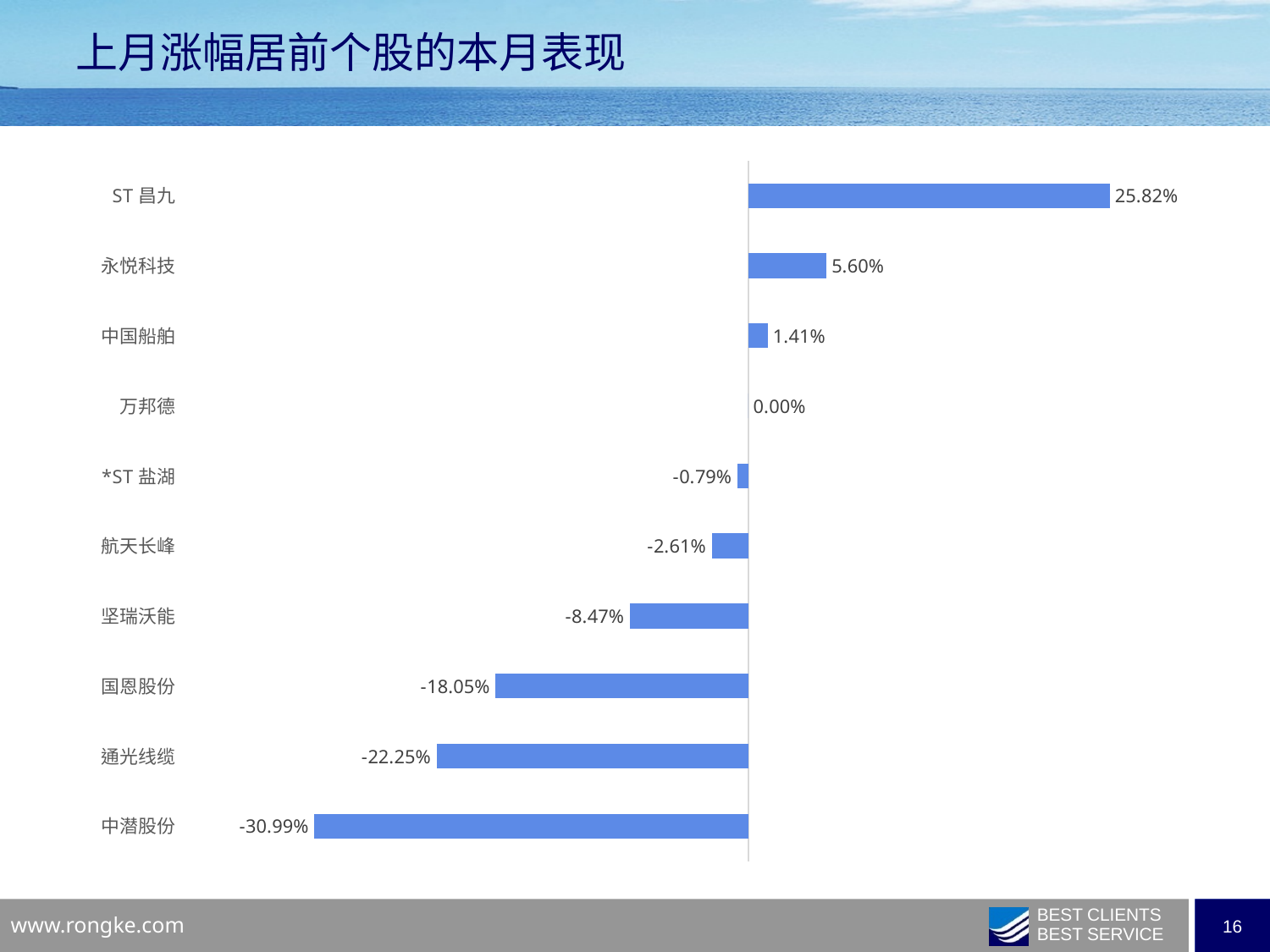
What is the value shown for 万邦德? 0.00% What is the difference between the values for 通光线缆 and 中潜股份? 8.74% Which stock has the highest value on the chart? ST 昌九 What is the value shown for 中潜股份? -30.99% What is the title of the slide? 上月涨幅居前个股的本月表现 Which has the larger value, 坚瑞沃能 or 航天长峰? 航天长峰 What kind of chart is shown on the slide? Bar chart What is the value shown for 国恩股份? -18.05% Which stock has the lowest value on the chart? 中潜股份 How many stocks are shown on the chart? 10 What is the difference between the values for ST 昌九 and 永悦科技? 20.22% What is the value shown for ST 昌九? 25.82%